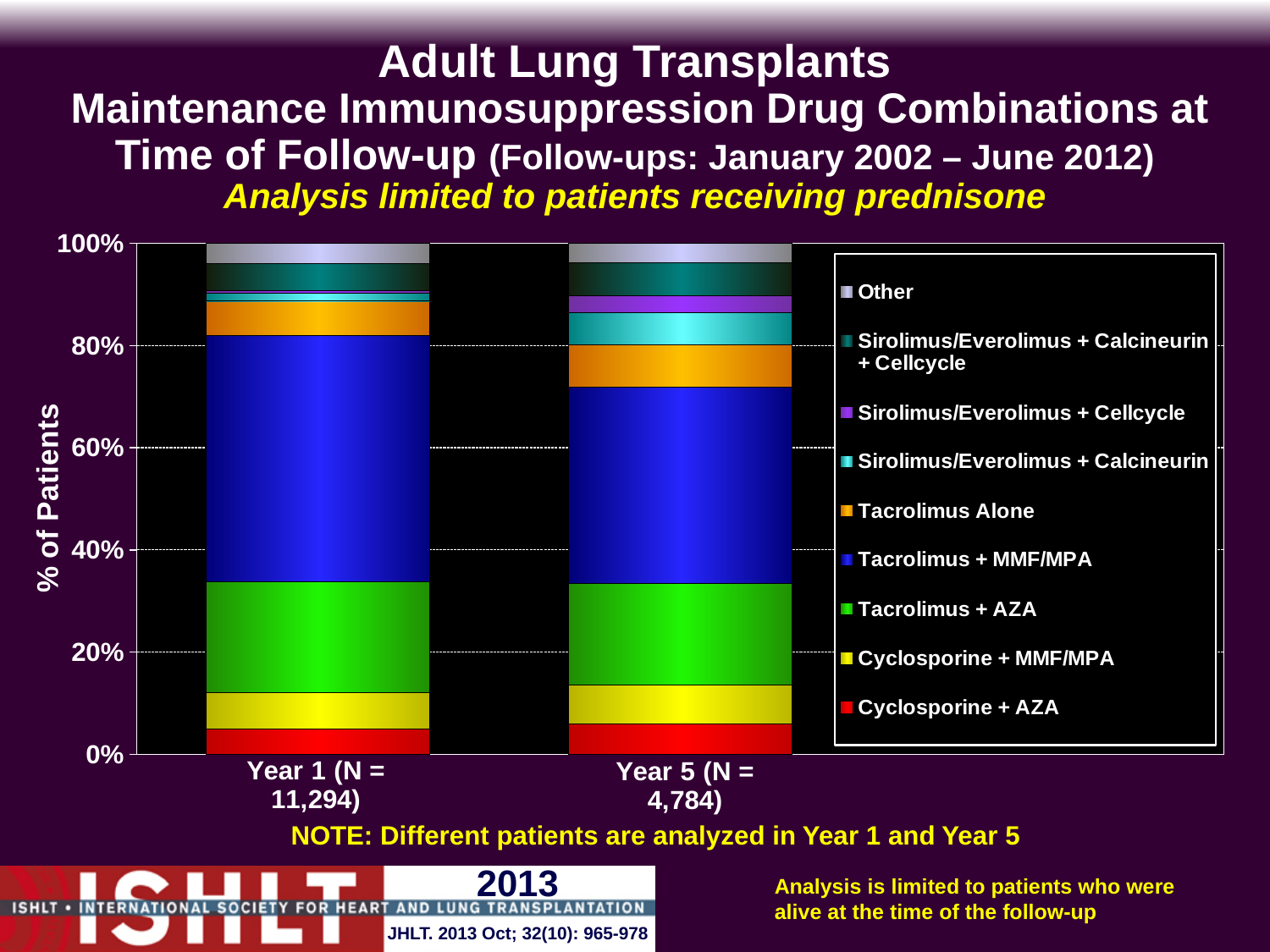
Which drug combination makes up the largest segment of the Year 5 bar? Tacrolimus + MMF/MPA What is the N shown for the Year 5 bar? 4,784 Is the Sirolimus/Everolimus + Calcineurin segment larger in Year 1 or in Year 5? Year 5 Which drug combination makes up the largest segment of the Year 1 bar? Tacrolimus + MMF/MPA What is the N shown for the Year 1 bar? 11,294 Is the share of Tacrolimus + MMF/MPA in Year 1 greater or less than 40%? greater What kind of chart is shown on the slide? Stacked bar chart Is the Tacrolimus + MMF/MPA segment larger in Year 1 or in Year 5? Year 1 Is the share of Cyclosporine + AZA in Year 1 greater or less than 20%? less How many bars (follow-up time points) are plotted in the chart? 2 What is the label on the y axis of the chart? % of Patients How many drug combination series does the legend list? 9